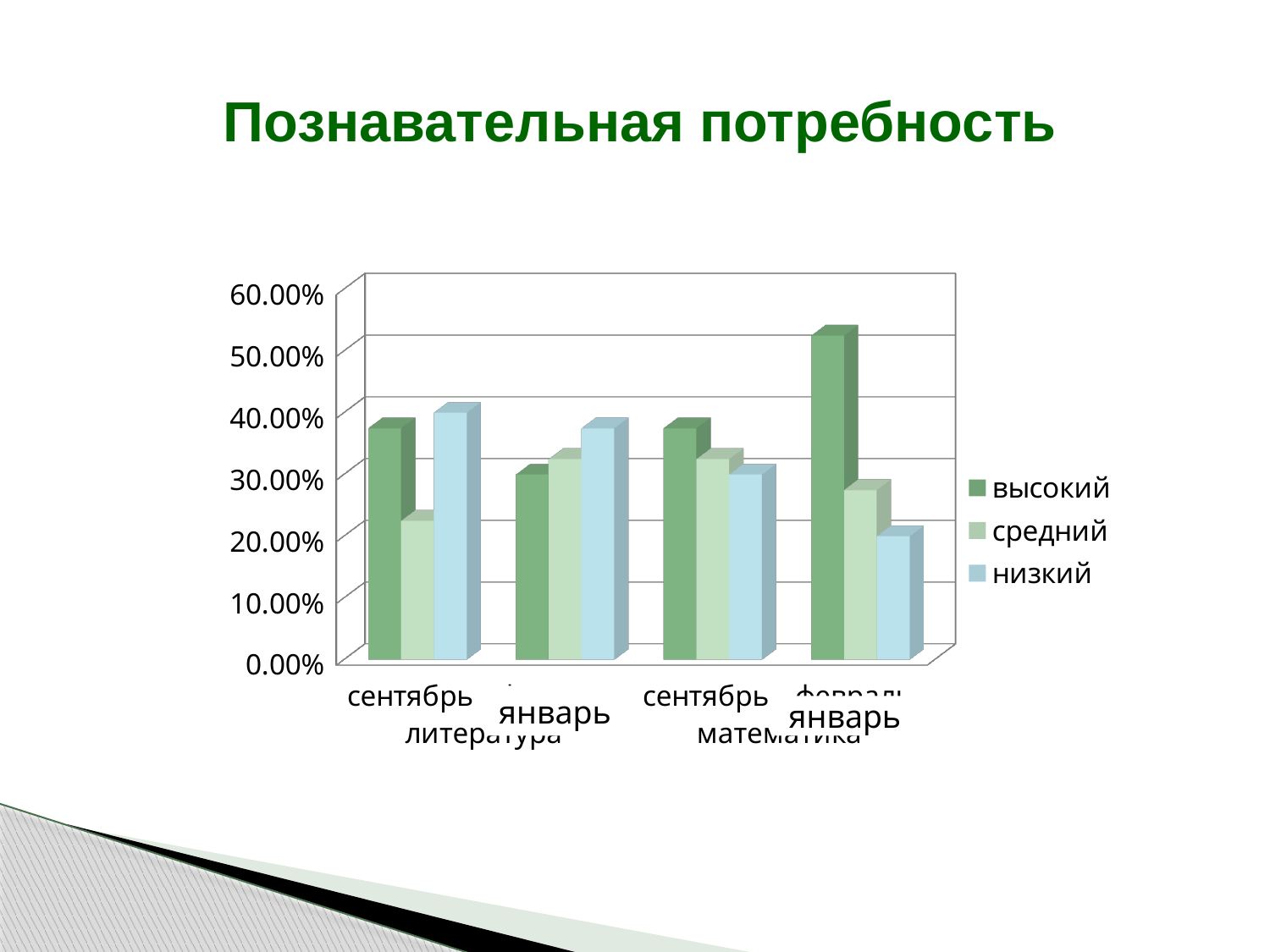
Which series has the lowest bar in the rightmost group (математика, январь)? низкий What are the three series named in the legend? высокий, средний, низкий Which series has the lowest bar in the сентябрь group for литература? средний How many groups of bars are plotted along the x axis? 4 In the сентябрь group for литература, which is larger: низкий or средний? низкий For математика, does the высокий value rise or fall from сентябрь to the later measurement? rise How many series does the legend list? 3 Is the value for высокий in the rightmost group (математика, январь) greater or less than 40.00%? greater What kind of chart is shown on the slide? bar chart Which series has the tallest bar in the rightmost group (математика, январь)? высокий Is the value for средний in the сентябрь group for литература greater or less than 30.00%? less Is the value for низкий in the rightmost group (математика, январь) greater or less than 30.00%? less